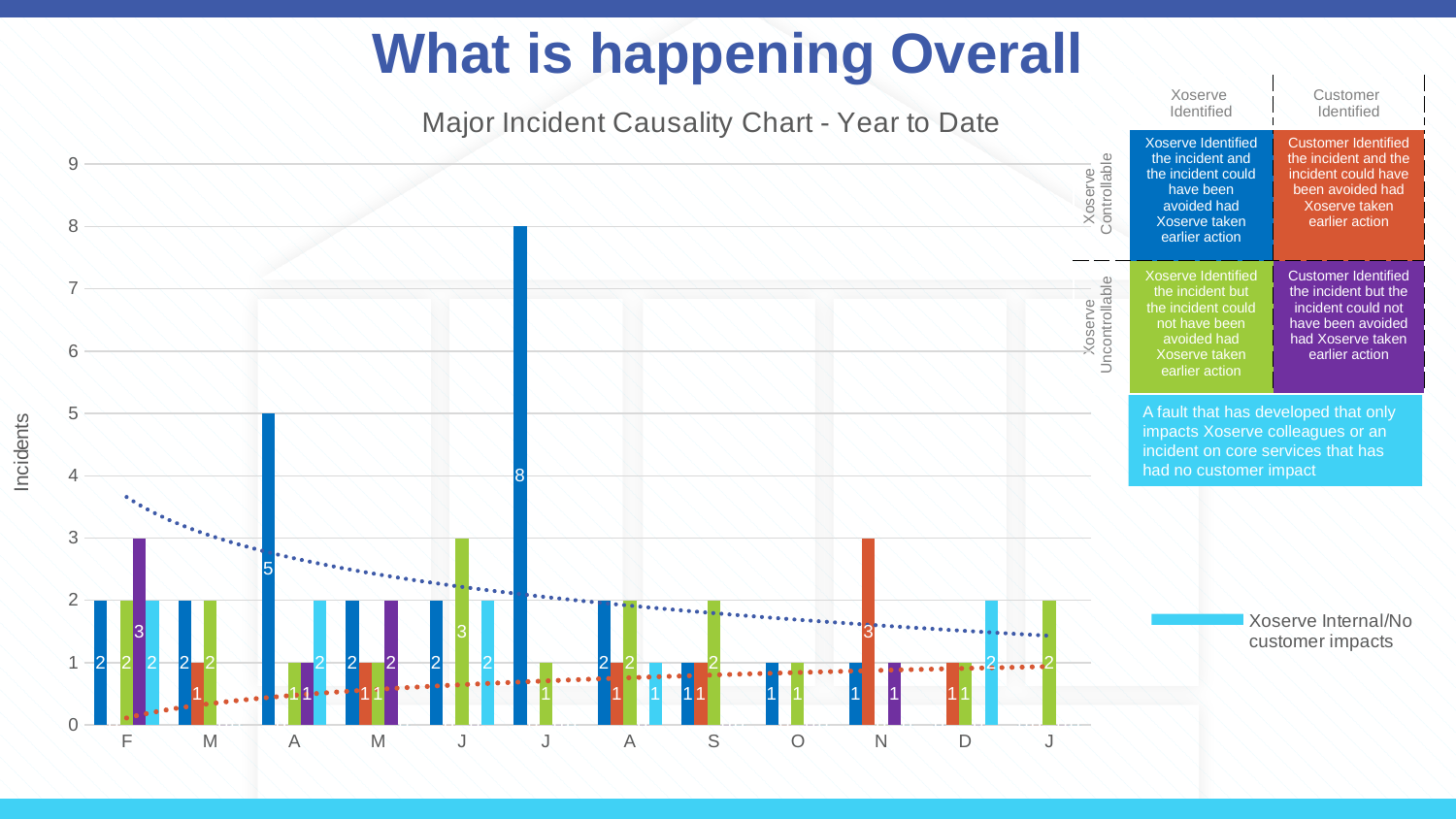
Is the tallest bar in the Major Incident Causality Chart greater or less than 7? greater How many months are shown along the x axis of the Major Incident Causality Chart? 12 What is the value of the dark blue bar for the month labelled A (the third category) in the Major Incident Causality Chart? 5 What type of chart is the Major Incident Causality Chart? bar chart Does the blue dotted trend line in the Major Incident Causality Chart rise or fall from left to right? fall What is the value of the orange bar for the month labelled N in the Major Incident Causality Chart? 3 What is the title of the y axis in the Major Incident Causality Chart? Incidents Which is larger in the Major Incident Causality Chart: the dark blue bar for the first A month or the green bar for the first J month? the dark blue bar for the first A month What is the value of the purple bar for the month labelled F in the Major Incident Causality Chart? 3 What is the difference between the tallest bar (8) and the dark blue bar for the first A month (5) in the Major Incident Causality Chart? 3 What is the value of the light blue bar for the month labelled D in the Major Incident Causality Chart? 2 What is the value of the tallest bar in the Major Incident Causality Chart? 8